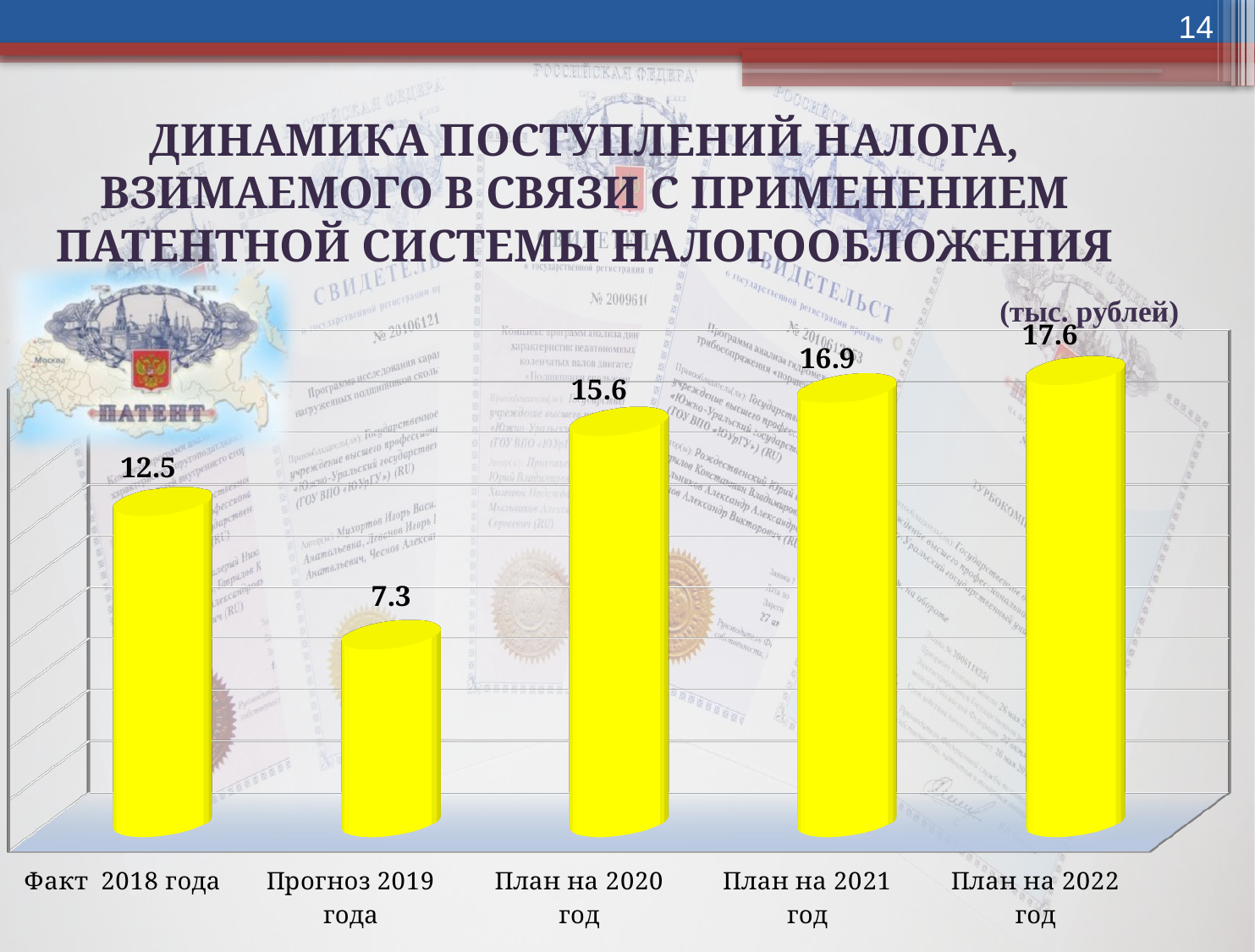
What is the difference between the values for План на 2022 год and План на 2020 год? 2.0 What kind of chart is shown on the slide? Bar chart Which is larger, the value for Факт 2018 года or the value for План на 2020 год? План на 2020 год What is the value for Факт 2018 года? 12.5 What is the difference between the values for Факт 2018 года and Прогноз 2019 года? 5.2 What is the value for Прогноз 2019 года? 7.3 Which category has the highest value? План на 2022 год In what units are the values on the chart given? тыс. рублей Which category has the lowest value? Прогноз 2019 года How many categories are shown on the chart? 5 What is the value for План на 2021 год? 16.9 Do the values rise or fall from План на 2020 год to План на 2022 год? Rise